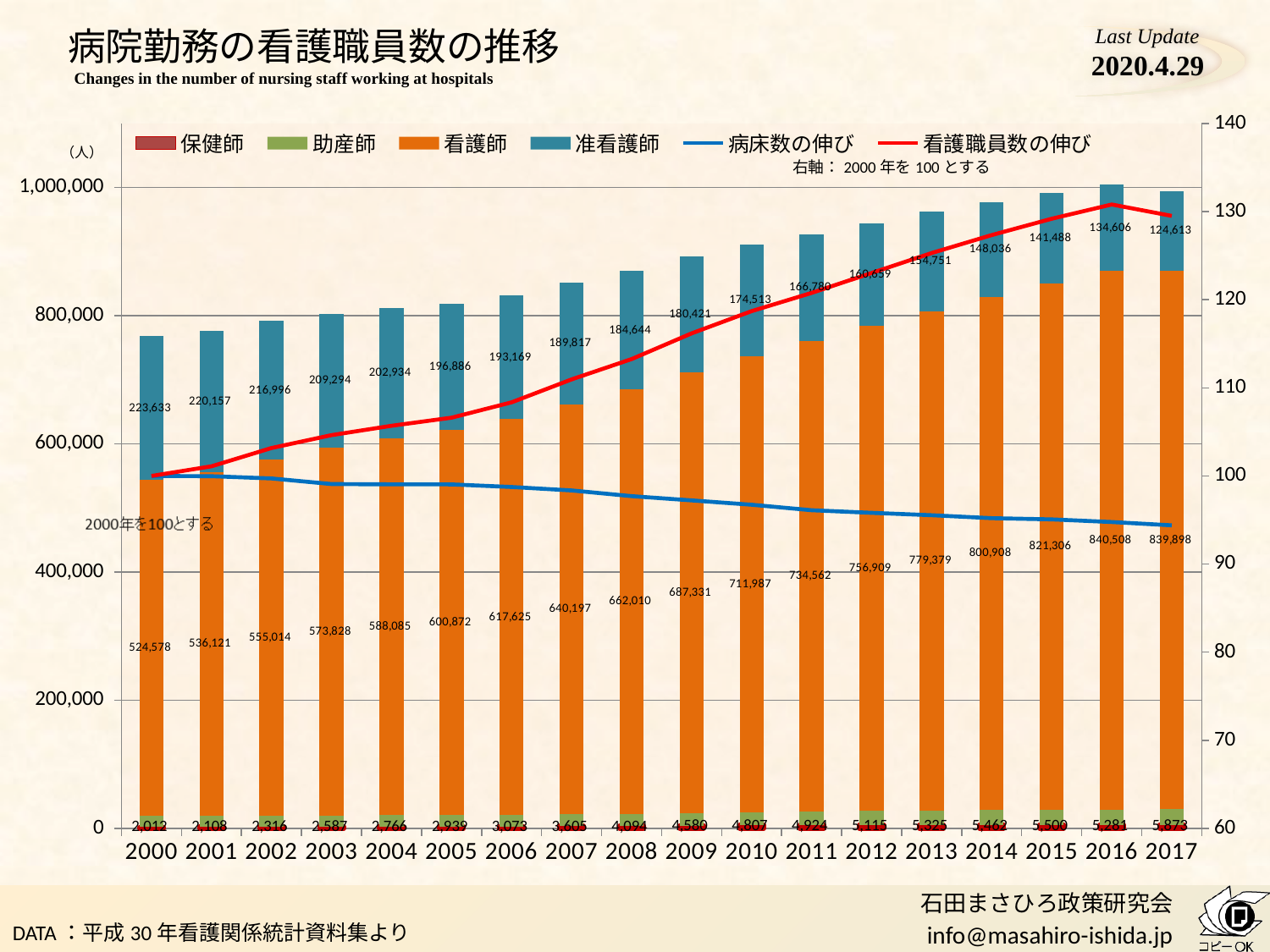
What is the difference between the 看護師 value in 2017 and in 2000? 315,320 Is the 病床数の伸び line value for 2017 greater or less than 100 on the right axis? less How many series does the legend list? 6 In which year is the 准看護師 value lowest? 2017 How many years are shown along the x axis? 18 What kind of chart is shown on the slide? A stacked bar chart combined with line series Which is larger in 2005, the 看護師 value or the 准看護師 value? 看護師 In which year is the 看護師 value highest? 2016 Do the 准看護師 values rise or fall from 2000 to 2017? Fall What is the value for 看護師 in 2010? 711,987 What is the difference between the 准看護師 value in 2000 and in 2017? 99,020 What is the value for 准看護師 in 2000? 223,633